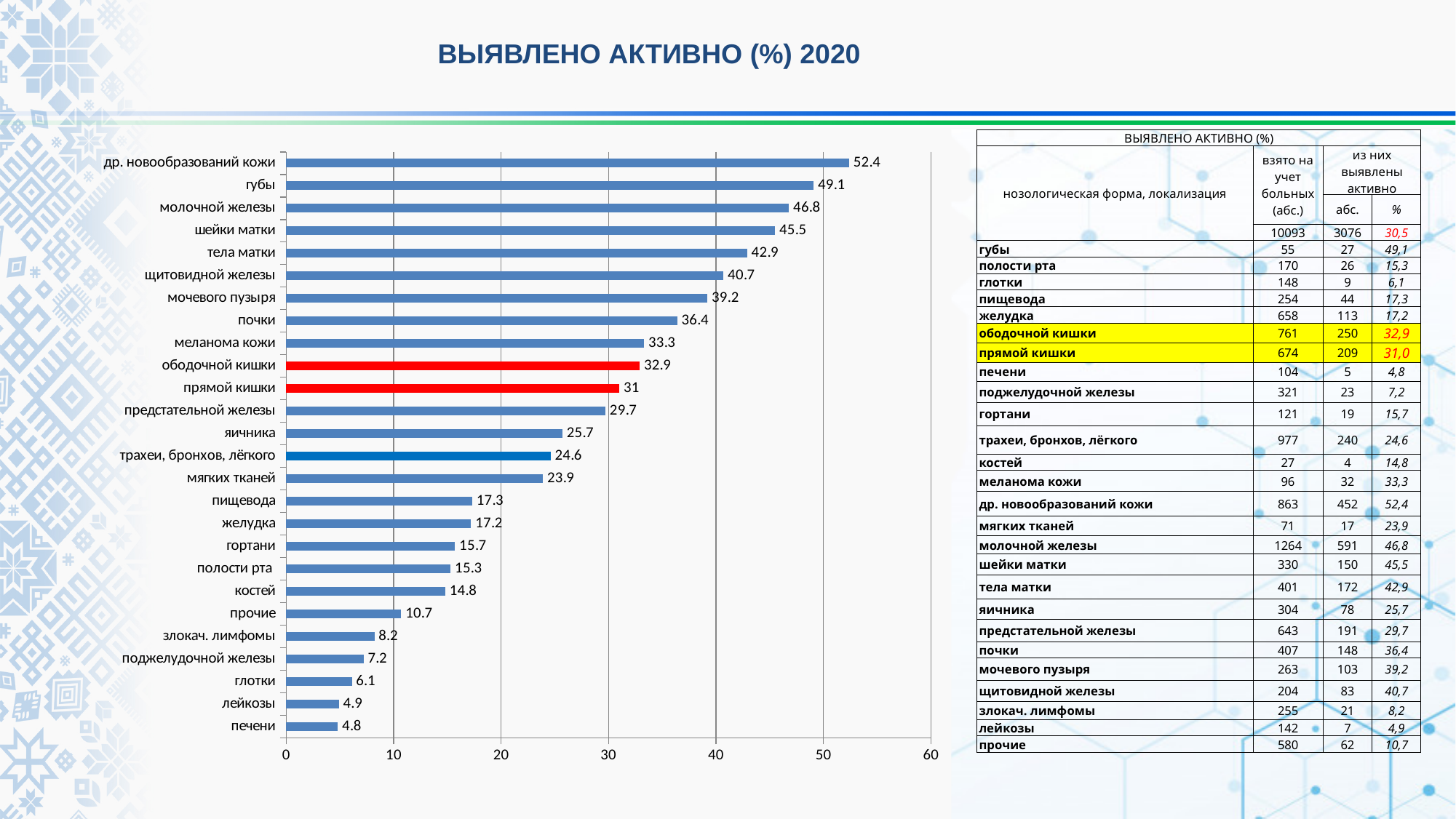
What is the value for «прямой кишки» in the chart? 31 What is the difference between the values for «губы» and «молочной железы» in the chart? 2.3 Which is larger in the chart: the value for «меланома кожи» or the value for «мочевого пузыря»? мочевого пузыря Which two bars in the chart are coloured red? ободочной кишки and прямой кишки Which category has the lowest value in the chart? печени What is the value for «почки» in the chart? 36.4 What is the difference between the values for «ободочной кишки» and «прямой кишки» in the chart? 1.9 Is the value for «тела матки» in the chart greater or less than 40? greater What type of chart is shown on the slide? bar chart What is the value for «др. новообразований кожи» in the chart? 52.4 Which category has the highest value in the chart? др. новообразований кожи How many categories are shown in the chart? 26